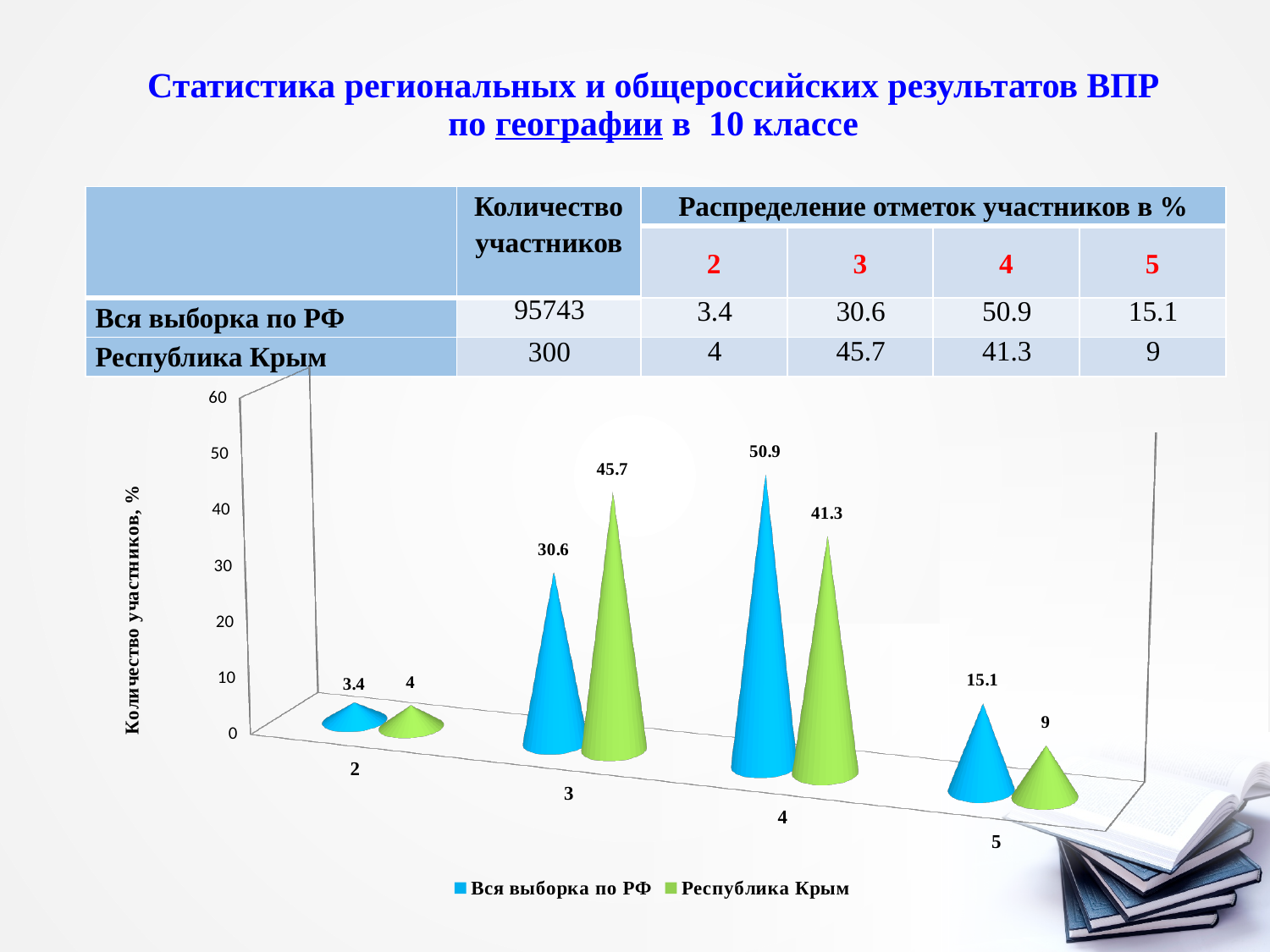
What is the difference between "Республика Крым" and "Вся выборка по РФ" at grade 3? 15.1 At grade 4, which series has the larger value: "Вся выборка по РФ" or "Республика Крым"? Вся выборка по РФ What is the value for "Вся выборка по РФ" at grade 4? 50.9 How many grade categories are shown on the x axis of the chart? 4 Is the value for "Вся выборка по РФ" at grade 5 greater or less than 20? less Which grade has the lowest value for "Республика Крым"? 2 Which grade has the highest value for "Вся выборка по РФ"? 4 What is the value for "Республика Крым" at grade 3? 45.7 How many series does the chart legend list? 2 What is the value for "Республика Крым" at grade 5? 9 What is the label of the vertical axis of the chart? Количество участников, % What kind of chart is shown on the slide? bar chart